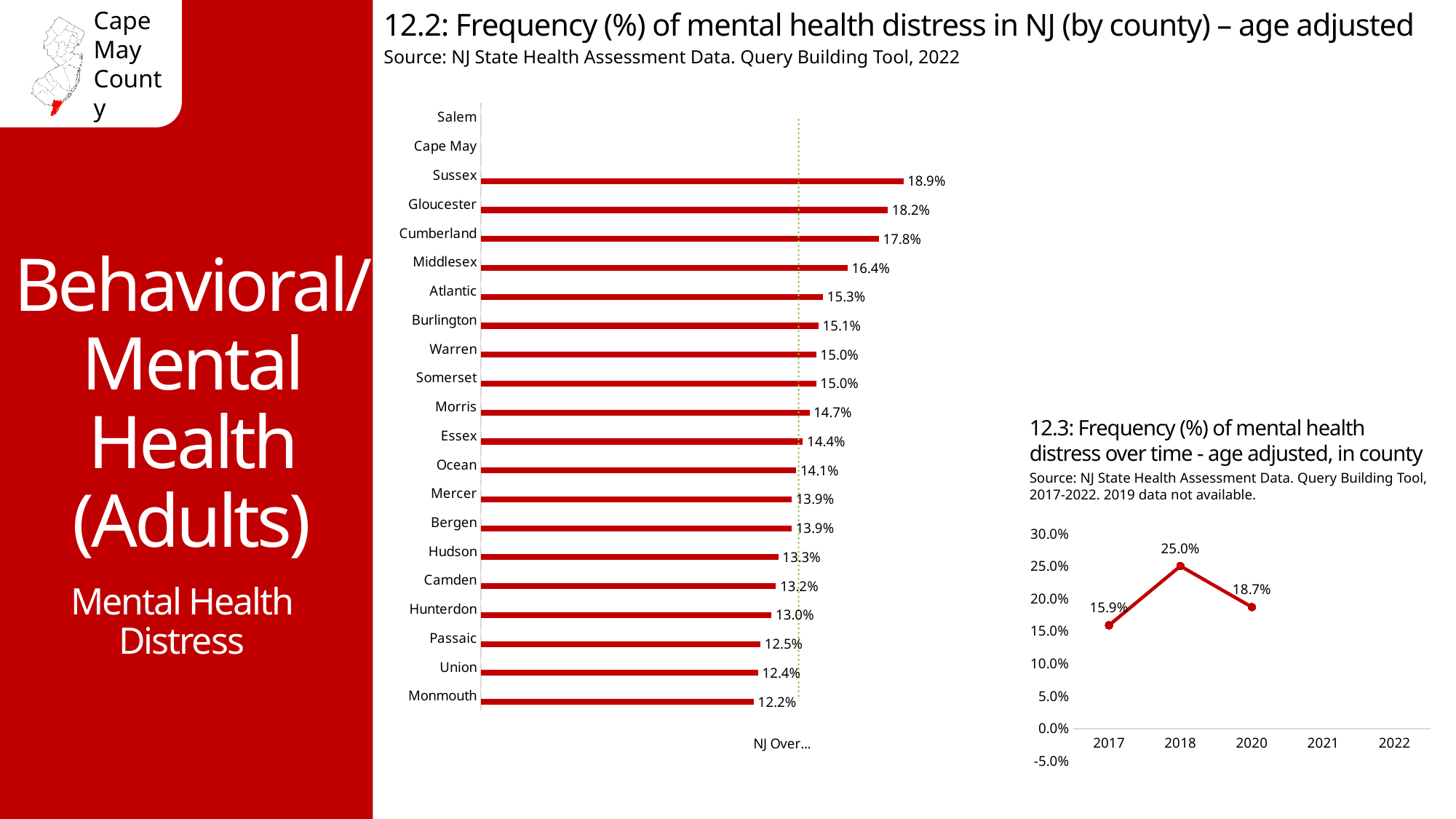
In chart 12.2, how many county labels are listed on the vertical axis? 21 In chart 12.3, how many data points are plotted on the line? 3 In chart 12.2, which county has the highest plotted value? Sussex In chart 12.3, what is the value for 2018? 25.0% In chart 12.2, what is the value for Monmouth? 12.2% In chart 12.3, what is the difference between the values for 2018 and 2020? 6.3% In chart 12.3, is the value for 2017 greater or less than 20.0%? less In chart 12.2, what is the difference between the values for Gloucester and Cumberland? 0.4% In chart 12.2, which county has the lowest plotted value? Monmouth In chart 12.2, what is the value for Sussex? 18.9% In chart 12.2, what kind of chart is shown? bar chart In chart 12.2, which is larger, the value for Middlesex or the value for Atlantic? Middlesex